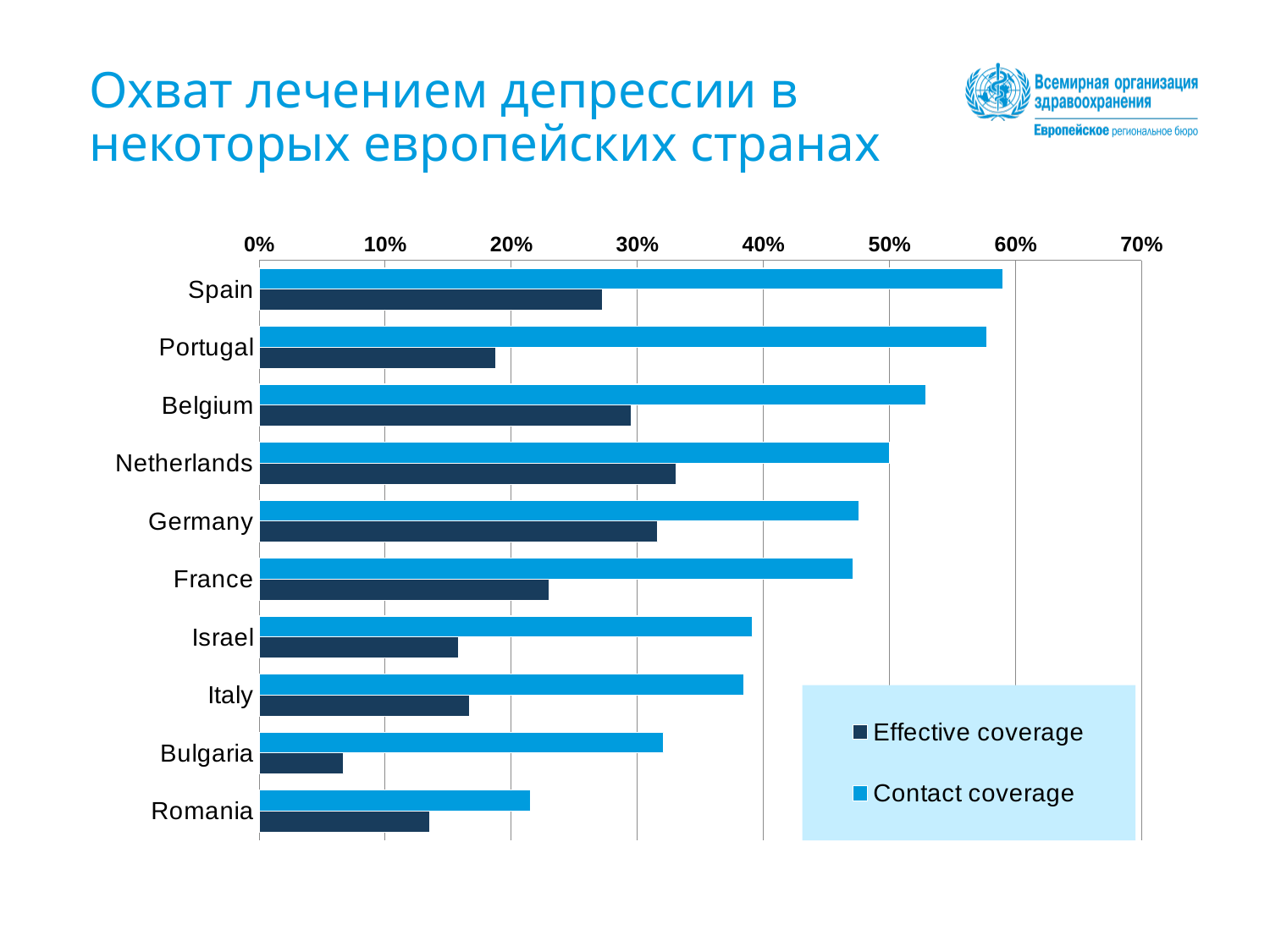
Which is larger, the Effective coverage for Spain or for Portugal? Spain Which is larger, the Contact coverage for Belgium or for Israel? Belgium Is the Effective coverage for Netherlands greater or less than 30%? greater How many countries are shown on the chart? 10 Which country has the lowest Contact coverage? Romania How many series does the legend list? 2 Which country has the lowest Effective coverage? Bulgaria Is the Contact coverage for Romania greater or less than 30%? less What kind of chart is shown on the slide? bar chart Is the Effective coverage for Bulgaria greater or less than 10%? less Which series is shown in dark blue in the legend? Effective coverage